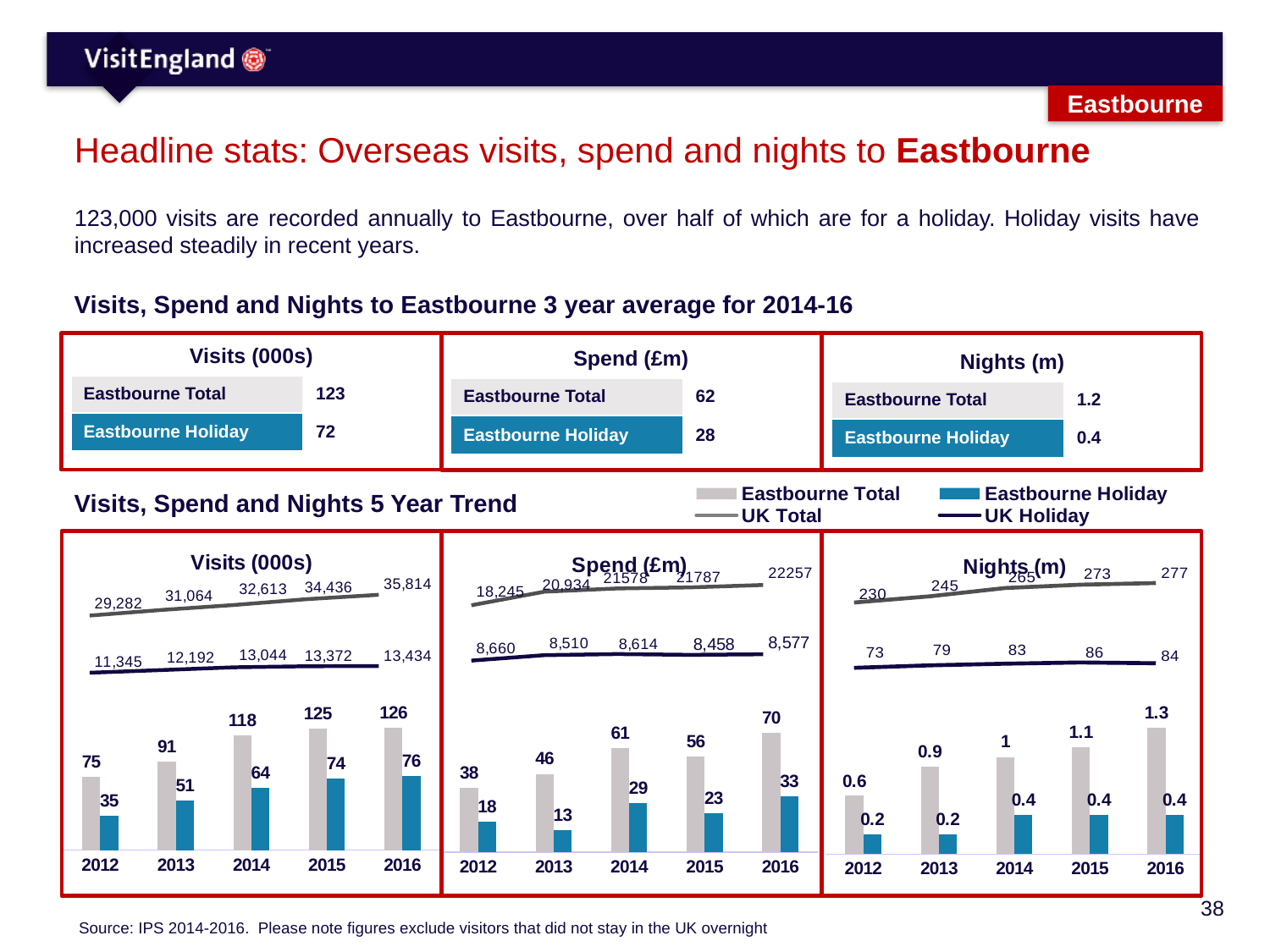
In the Spend (£m) trend chart, what is the Eastbourne Holiday value for 2016? 33 How many series does the legend for the 5 Year Trend charts list? 4 In the Spend (£m) trend chart, which is larger: Eastbourne Total spend in 2014 or in 2015? 2014 In the Nights (m) trend chart, what is the UK Total value for 2015? 273 In the Visits (000s) trend chart, do the UK Total values rise or fall from 2012 to 2016? Rise What kind of chart is used for the Eastbourne Total and Eastbourne Holiday values in the Visits (000s) trend chart? Bar chart In the Spend (£m) trend chart, which year has the highest Eastbourne Total spend? 2016 In the Spend (£m) trend chart, which year has the lowest Eastbourne Holiday spend? 2013 How many years are shown on the x axis of the Nights (m) trend chart? 5 In the Visits (000s) trend chart, what is the difference between Eastbourne Total and Eastbourne Holiday visits in 2016? 50 In the 5 Year Trend charts, which colour represents Eastbourne Holiday? Blue In the Visits (000s) trend chart, what is the Eastbourne Total value for 2014? 118